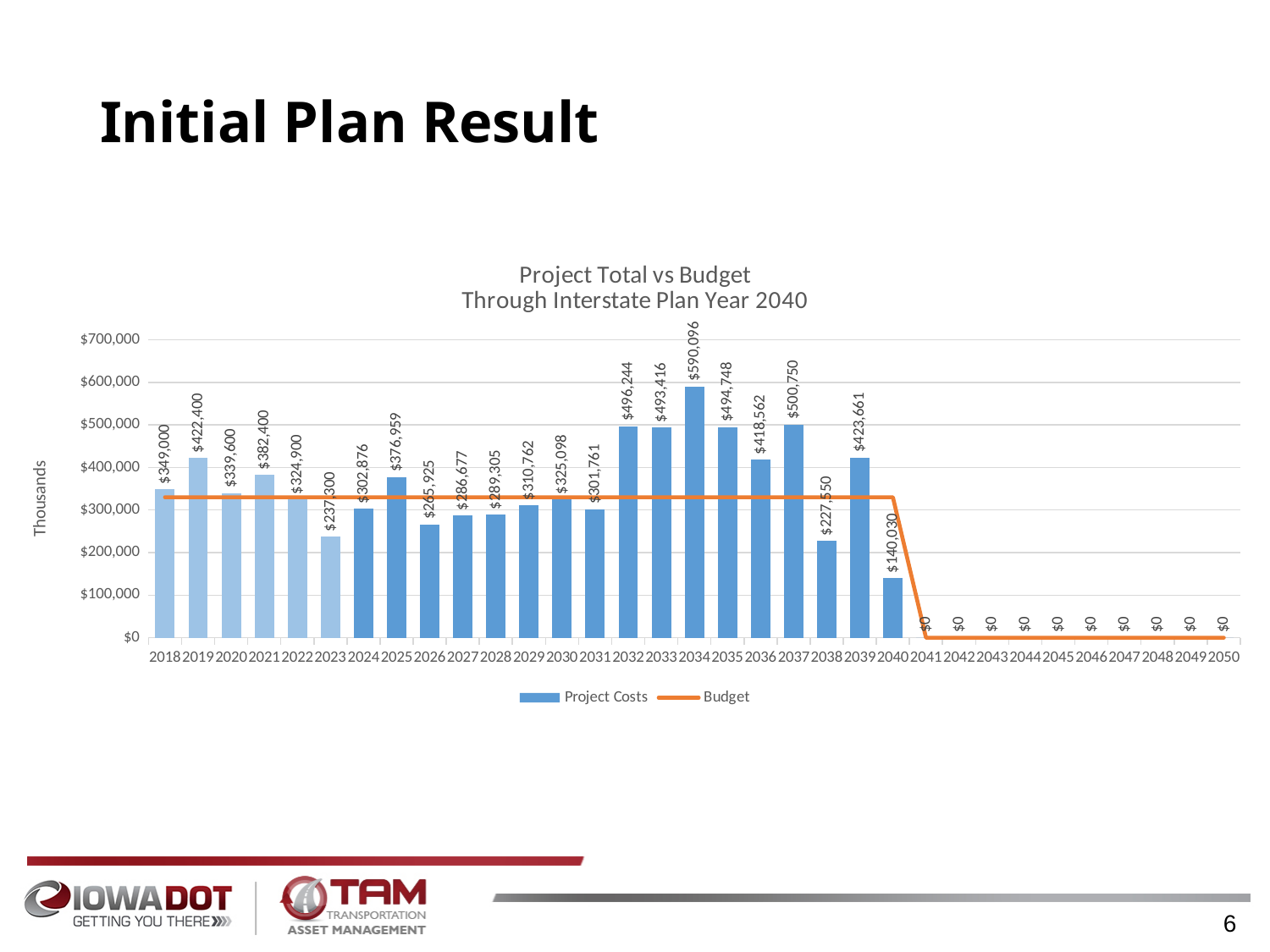
How many series does the legend list? 2 Which year has the highest Project Costs? 2034 What is the Project Costs value for 2034? $590,096 What kind of chart is used to show Project Costs? Bar chart Is the Budget line value for 2030 greater or less than $300,000? greater What is the Project Costs value for 2040? $140,030 How many years are shown on the x axis? 33 What is the difference between the Project Costs for 2034 and 2037? $89,346 What is the Project Costs value for 2023? $237,300 What is the title of the chart? Project Total vs Budget Through Interstate Plan Year 2040 Which year has higher Project Costs, 2019 or 2021? 2019 Among the years with non-zero Project Costs, which year has the lowest value? 2040